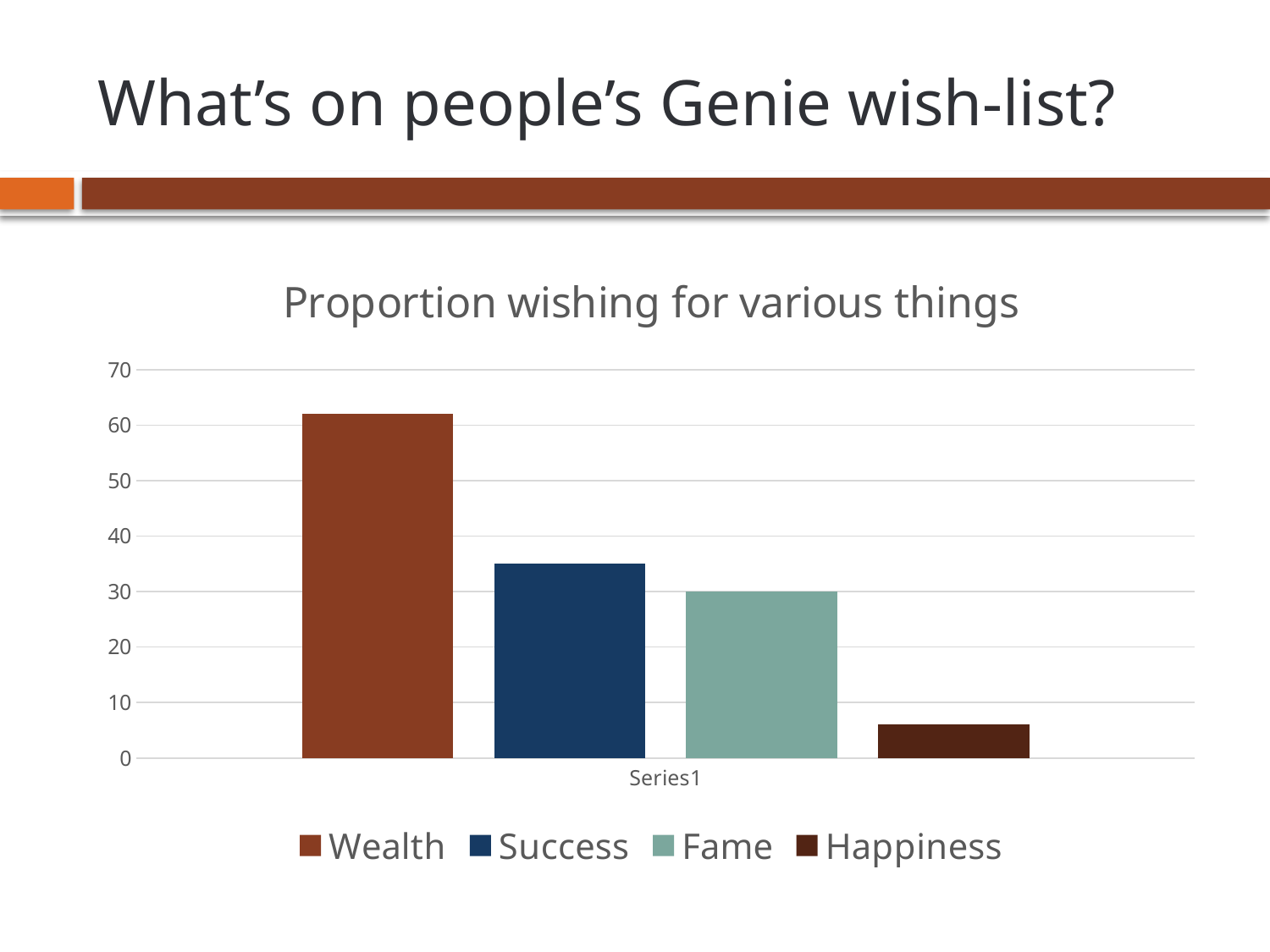
Which is larger, the value for Wealth or the value for Happiness? Wealth Which wish has the lowest proportion? Happiness Is the value for Wealth greater or less than 60? greater What is the title of the chart? Proportion wishing for various things Is the value for Happiness greater or less than 10? less What kind of chart is shown on the slide? bar chart How many entries does the chart's legend list? 4 How many bars are plotted in the chart? 4 Is the value for Success greater or less than 40? less Do the bar values rise or fall from left to right across the chart? fall Which wish has the highest proportion? Wealth Which is larger, the value for Success or the value for Fame? Success